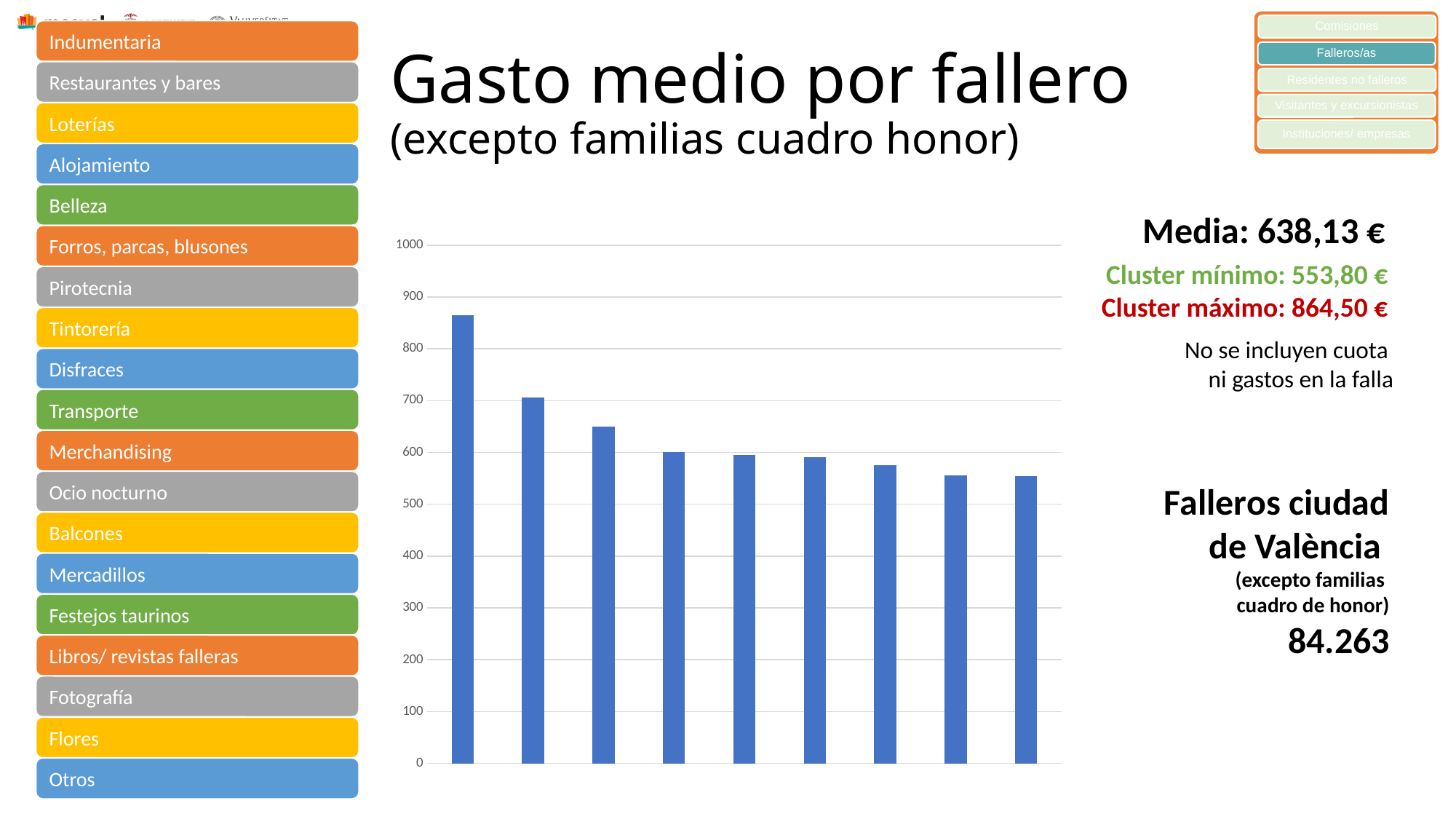
Is the value of the rightmost bar greater or less than 600? less Is the value of the rightmost bar greater or less than 500? greater Is the value of the third bar from the left greater or less than 600? greater Which is larger, the leftmost bar or the rightmost bar? the leftmost bar What is the title of the slide containing the chart? Gasto medio por fallero (excepto familias cuadro honor) Do the bar values rise or fall from left to right across the chart? fall Which bar has the highest value in the chart? the leftmost (first) bar How many bars are plotted in the chart? 9 What kind of chart is shown on the slide? bar chart